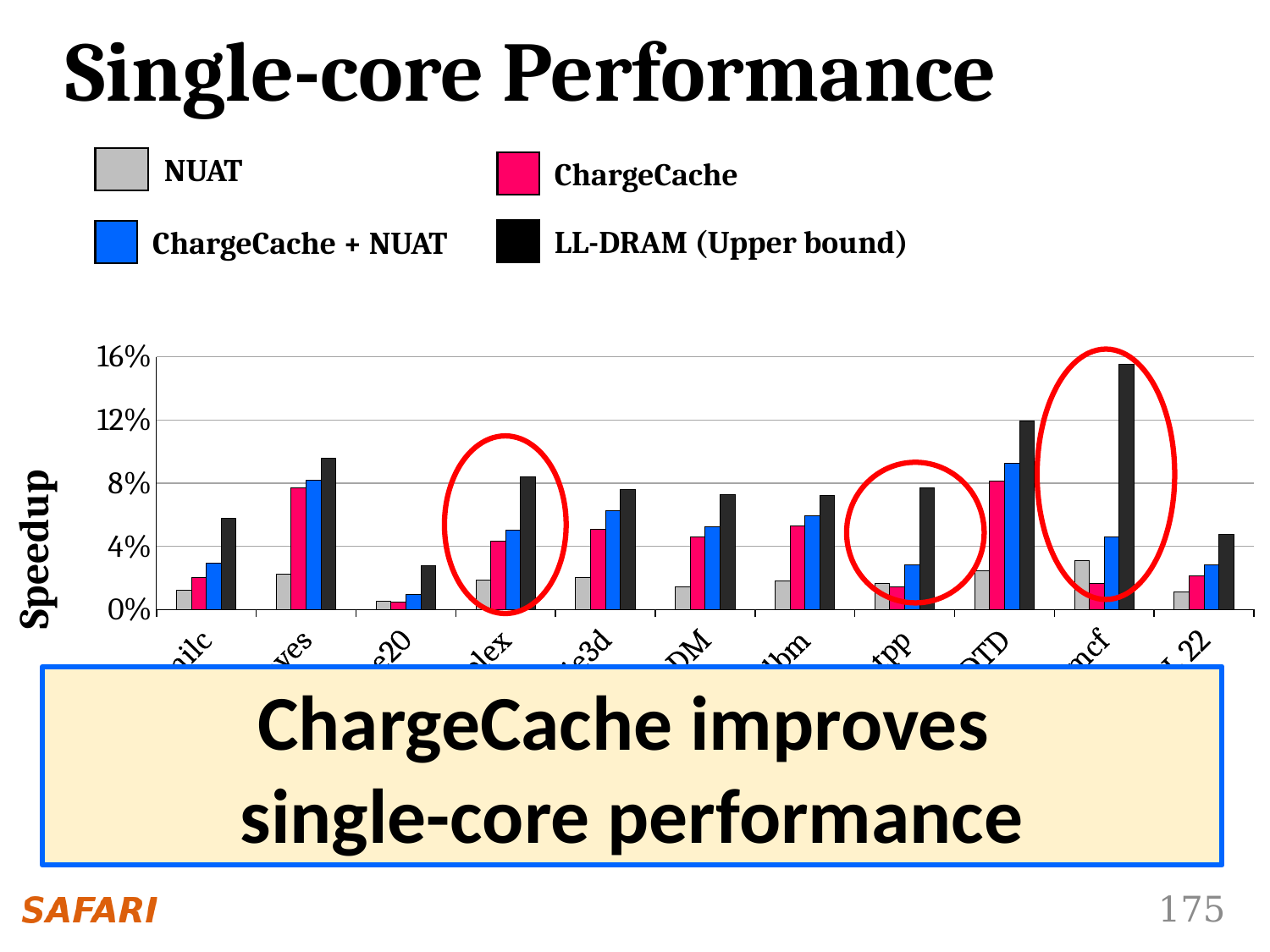
Is the LL-DRAM (Upper bound) value for the tenth category group from the left greater or less than 12%? greater Which series has the tallest bar in every category group? LL-DRAM (Upper bound) How many series does the legend list? 4 In the first category group from the left, which is larger: the ChargeCache + NUAT bar or the NUAT bar? ChargeCache + NUAT What is the highest tick value shown on the y axis? 16% What kind of chart is shown on the slide? bar chart Is the ChargeCache value for the third category group from the left greater or less than 4%? less Is the LL-DRAM (Upper bound) value for the first category group from the left greater or less than 4%? greater Which series is represented by the black bars in the legend? LL-DRAM (Upper bound) In the tenth category group from the left, which is larger: the ChargeCache + NUAT bar or the ChargeCache bar? ChargeCache + NUAT What is the label of the y axis? Speedup How many category groups of bars are plotted along the x axis? 11